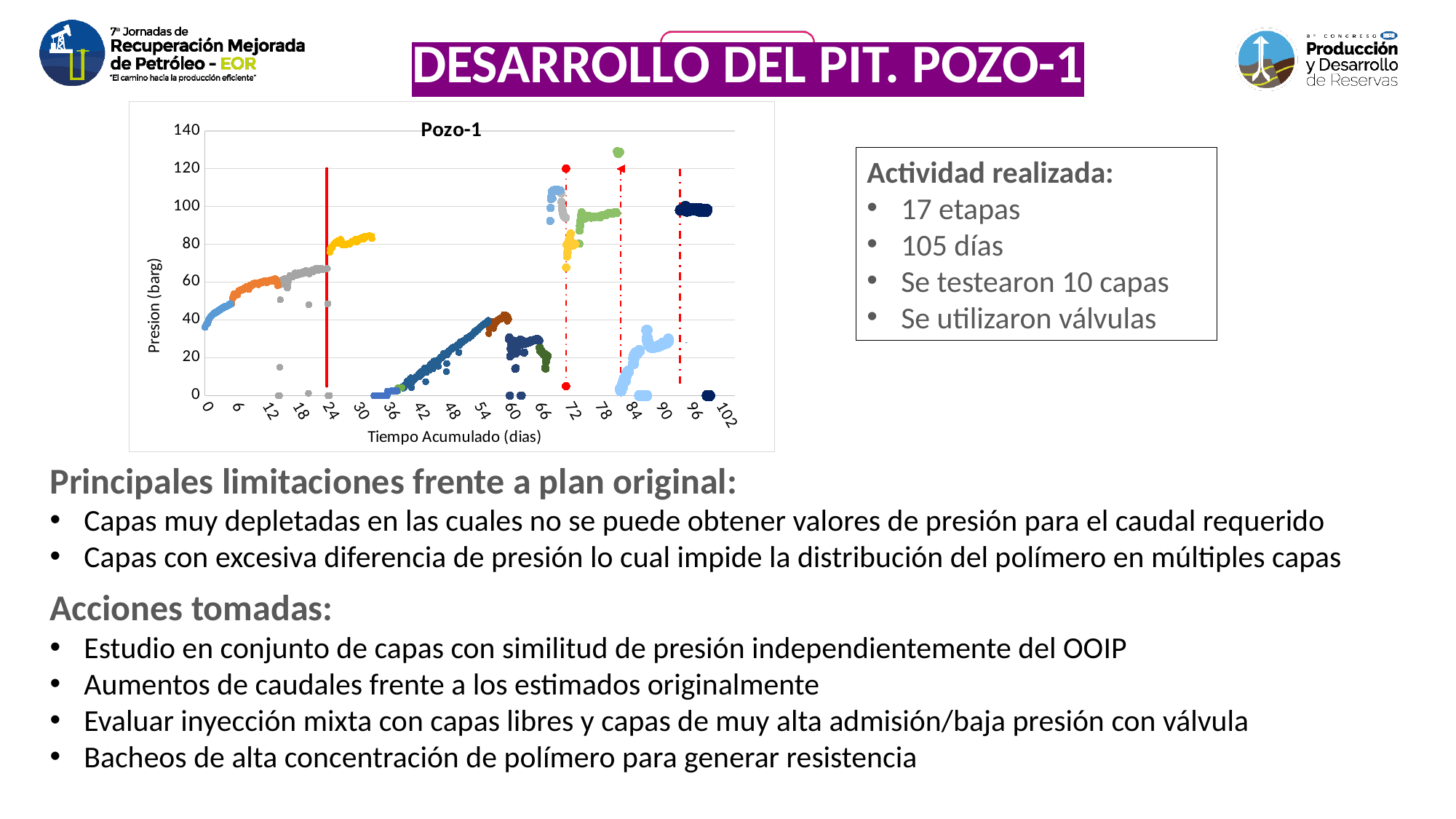
What is the highest value shown on the y axis of the chart? 140 Is the pressure plotted around day 30 greater or less than 60 barg? greater What kind of chart is shown on the slide? Scatter chart What is the label of the y axis of the chart? Presion (barg) Is the pressure plotted around day 96 greater or less than 80 barg? greater Is the pressure plotted around day 96 larger or smaller than the pressure plotted around day 48? larger Between day 36 and day 54, does the plotted pressure rise or fall? rise Is the highest pressure point plotted on the chart greater or less than 120 barg? greater What is the title of the chart? Pozo-1 Between day 0 and day 24, does the plotted pressure rise or fall? rise What is the last tick value shown on the x axis of the chart? 102